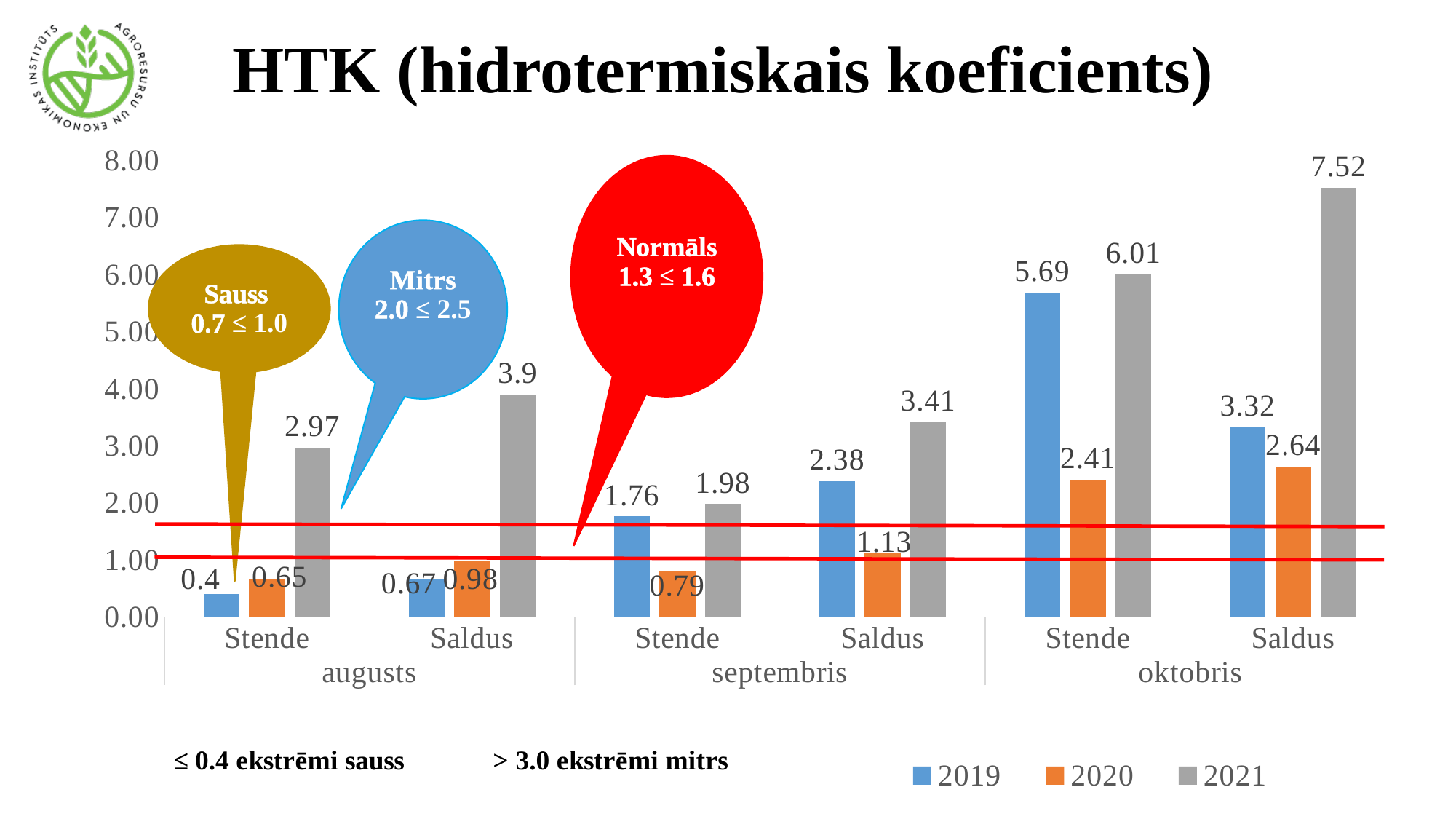
What is the 2021 value for Saldus in oktobris? 7.52 Which is larger for Saldus in septembris: the 2019 value or the 2021 value? 2021 (3.41) Is the 2021 value for Saldus in augusts greater or less than 3.00? greater How many location-month groups are shown on the x axis? 6 What is the title of the chart? HTK (hidrotermiskais koeficients) What is the 2019 value for Stende in augusts? 0.4 Which bar has the highest value on the chart? 2021, Saldus, oktobris (7.52) Which bar has the lowest value on the chart? 2019, Stende, augusts (0.4) How many series does the legend list? 3 What is the 2020 value for Saldus in septembris? 1.13 What is the difference between the 2021 and 2019 values for Stende in oktobris? 0.32 What kind of chart is shown on the slide? bar chart